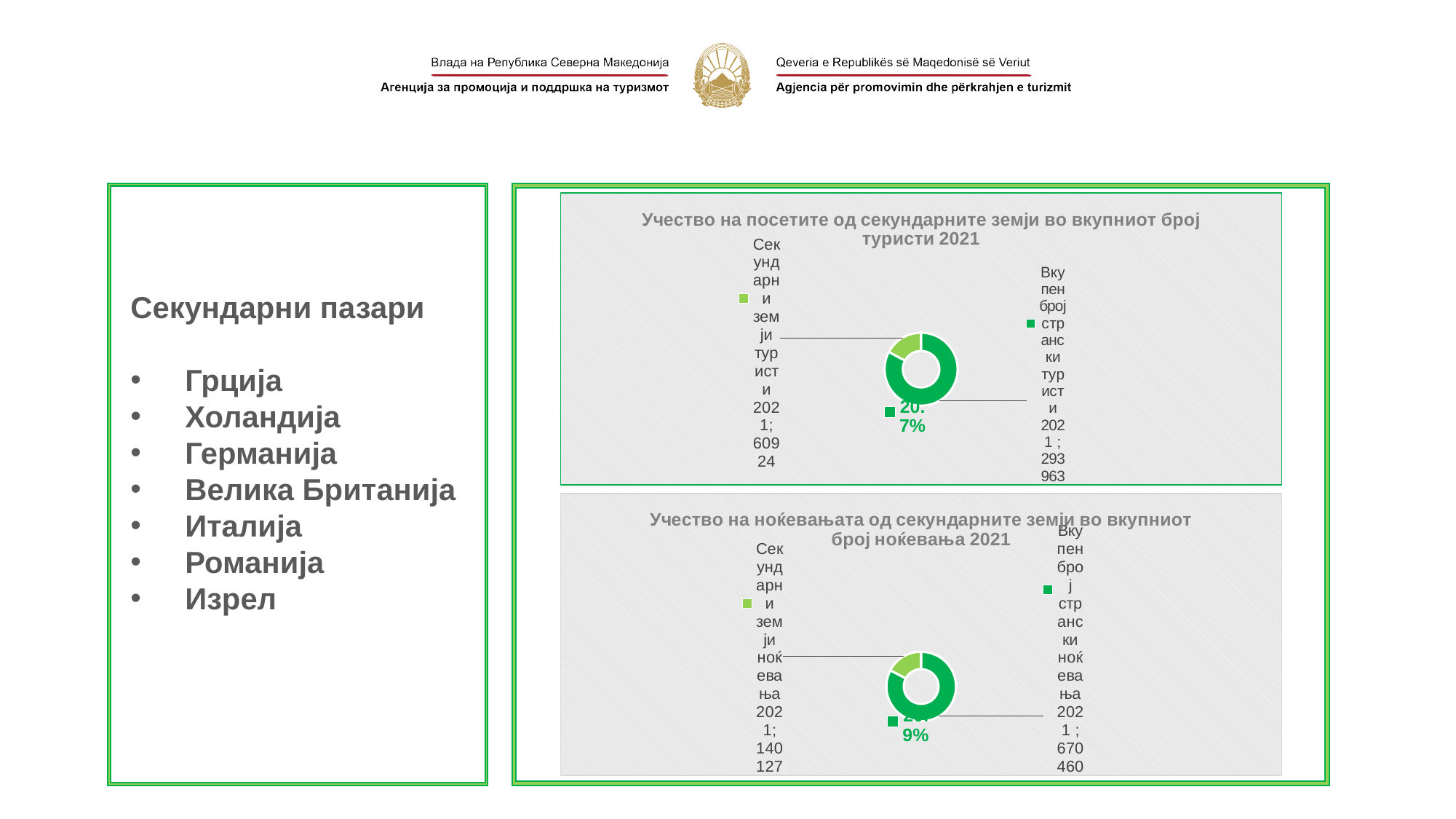
In the bottom chart, which category has the smaller value? Секундарни земји ноќевања 2021 In the top chart, what is the value for 'Вкупен број странски туристи 2021'? 293963 How many slices does the bottom chart have? 2 In the top chart, what is the difference between the value for 'Вкупен број странски туристи 2021' and 'Секундарни земји туристи 2021'? 233039 In the top chart, what is the value for 'Секундарни земји туристи 2021'? 60924 What kind of chart is the top chart, 'Учество на посетите од секундарните земји во вкупниот број туристи 2021'? Doughnut (pie) chart How many slices does the top chart have? 2 What is the title of the bottom chart? Учество на ноќевањата од секундарните земји во вкупниот број ноќевања 2021 In the bottom chart, what is the value for 'Вкупен број странски ноќевања 2021'? 670460 In the bottom chart, what is the value for 'Секундарни земји ноќевања 2021'? 140127 In the top chart, which category has the larger value: 'Секундарни земји туристи 2021' or 'Вкупен број странски туристи 2021'? Вкупен број странски туристи 2021 In the top chart, what percentage share is printed on the doughnut? 20.7%